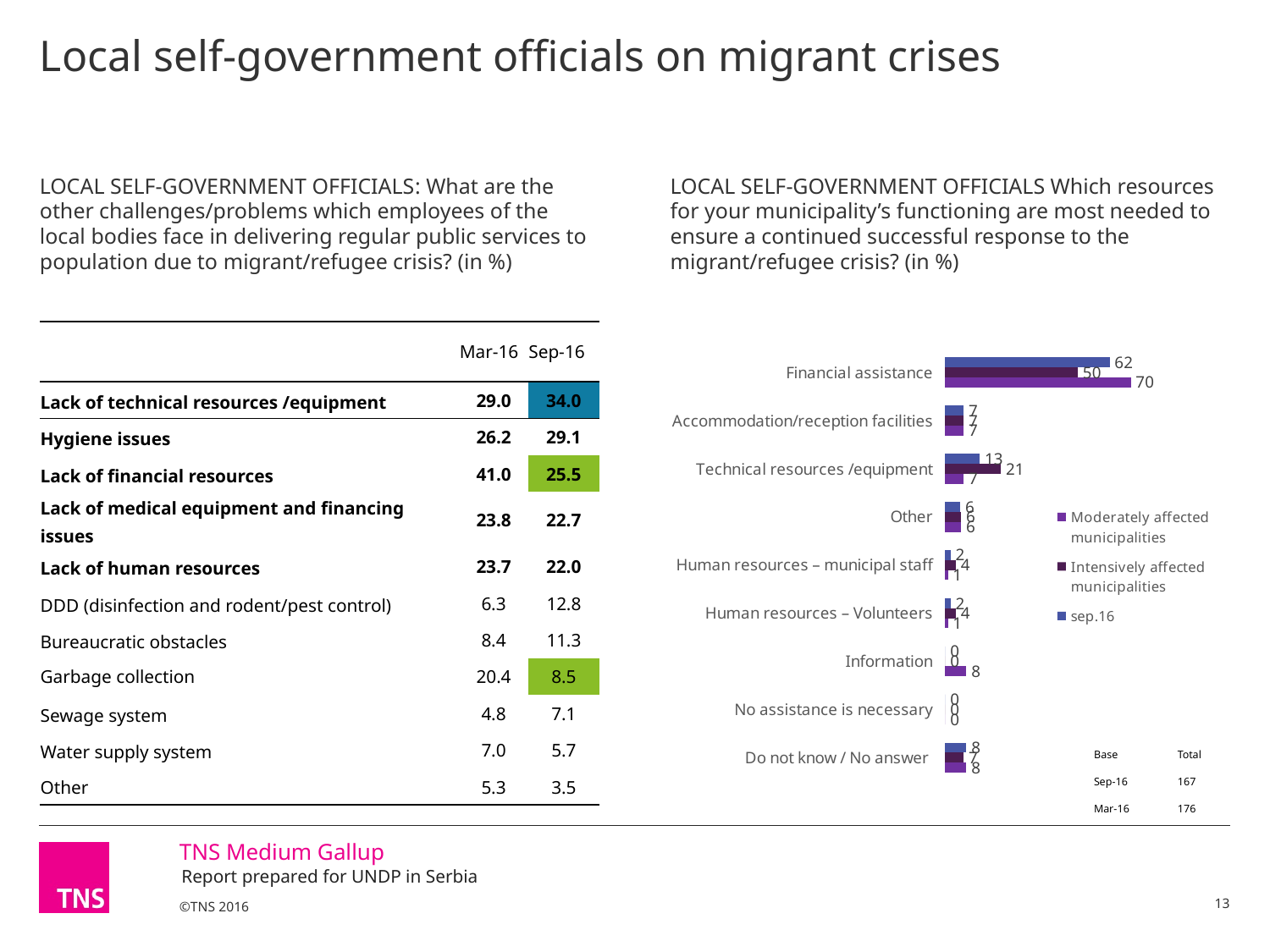
In the chart on the right, which category has a value of 0 for all three series? No assistance is necessary What kind of chart is shown on the right side of the slide? bar chart In the chart on the right, what is the sep.16 value for Information? 0 In the chart on the right, what is the difference between the sep.16 value and the Moderately affected municipalities value for Financial assistance? 8 How many series does the legend of the chart on the right list? 3 In the chart on the right, what is the value for Technical resources /equipment among Intensively affected municipalities? 21 How many categories are plotted in the chart on the right? 9 In the chart on the right, what is the value for Financial assistance among Intensively affected municipalities? 50 In the chart on the right, what is the value for Accommodation/reception facilities among Moderately affected municipalities? 7 In the chart on the right, what is the sep.16 value for Financial assistance? 62 In the chart on the right, for Technical resources /equipment, which is larger: the value for Moderately affected municipalities or for Intensively affected municipalities? Intensively affected municipalities In the chart on the right, which category has the highest values across all series? Financial assistance